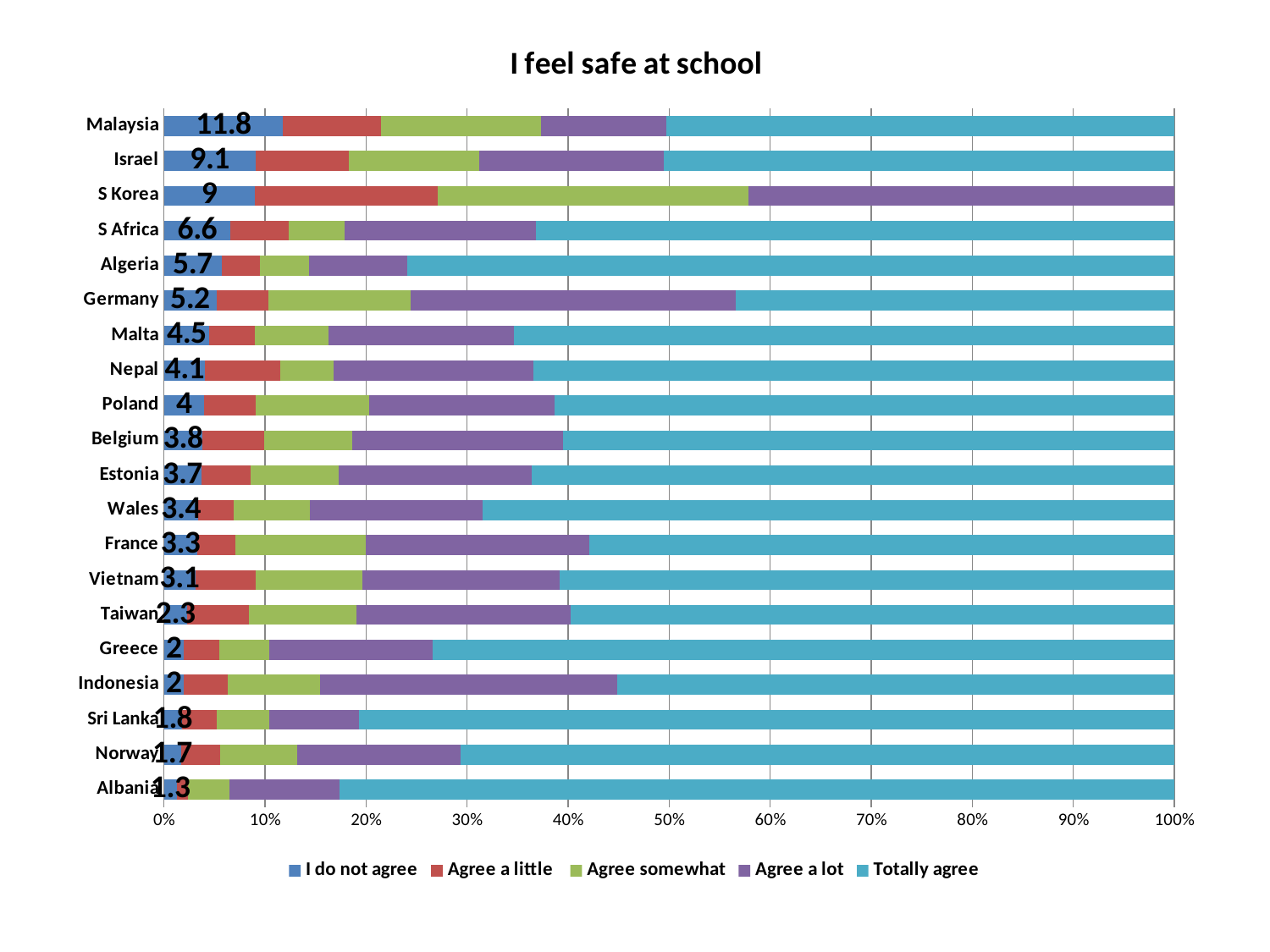
Is the 'Totally agree' value for Albania greater or less than 70%? greater How many countries are shown on the chart? 20 What is the 'I do not agree' value for Malaysia? 11.8 Which has a larger 'I do not agree' value, Algeria or Germany? Algeria What is the difference between the 'I do not agree' values for Malaysia and Israel? 2.7 Which country has the lowest 'I do not agree' value? Albania What is the title of the chart? I feel safe at school Which country has the highest 'I do not agree' value? Malaysia How many series does the legend list? 5 What is the 'I do not agree' value for Albania? 1.3 What kind of chart is shown on the slide? Stacked bar chart What is the 'I do not agree' value for Germany? 5.2